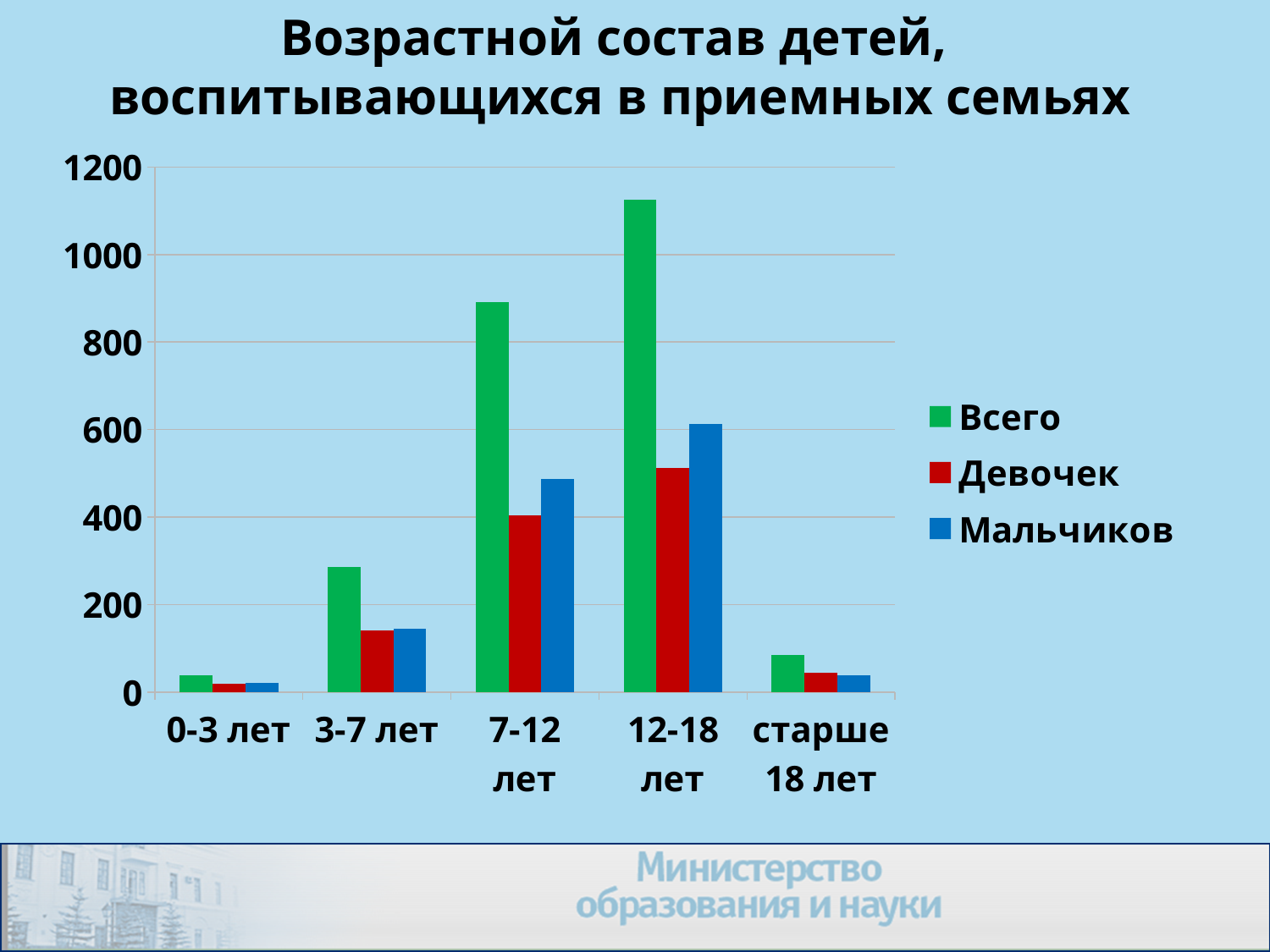
Which age category has the lowest value for Всего? 0-3 лет Which age category has the highest value for Мальчиков? 12-18 лет Is the value for Всего in the 7-12 лет category greater or less than 800? greater In the 7-12 лет category, which is larger: Девочек or Мальчиков? Мальчиков Is the value for Девочек in the 12-18 лет category greater or less than 600? less How many series does the legend list? 3 What colour represents the Всего series in the legend? green What kind of chart is shown on the slide? bar chart In the 12-18 лет category, which is larger: Девочек or Мальчиков? Мальчиков Which age category has the highest value for Всего? 12-18 лет Is the value for Всего in the 12-18 лет category greater or less than 1000? greater How many age categories are shown on the x axis? 5